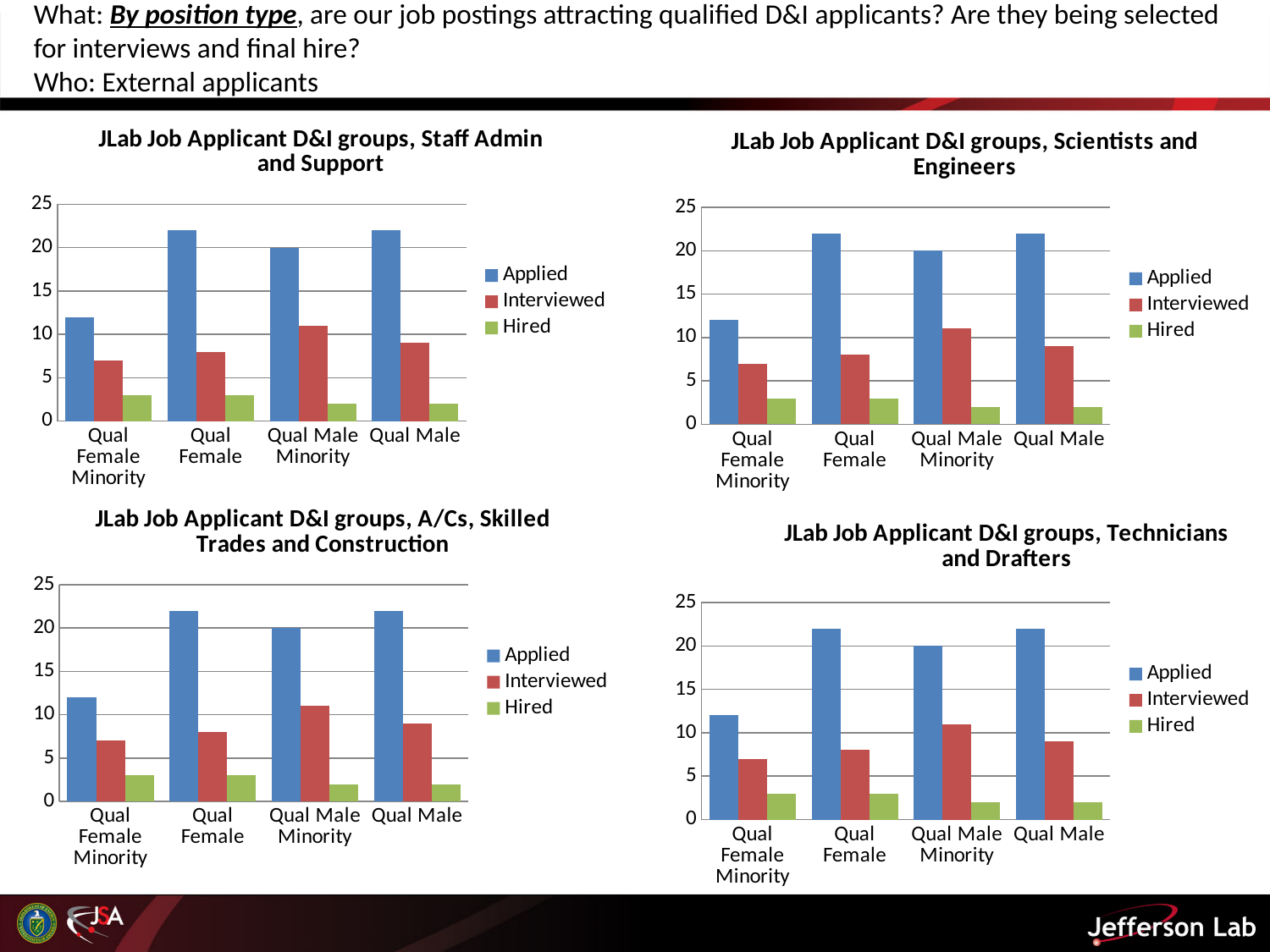
In the 'JLab Job Applicant D&I groups, A/Cs, Skilled Trades and Construction' chart, is the Hired value for Qual Male greater or less than 5? less In the 'JLab Job Applicant D&I groups, Technicians and Drafters' chart, how many categories are shown on the x axis? 4 In the 'JLab Job Applicant D&I groups, Scientists and Engineers' chart, is the Applied value for Qual Female Minority greater or less than 10? greater In the 'JLab Job Applicant D&I groups, Staff Admin and Support' chart, which is larger: the Interviewed value for Qual Male Minority or the Interviewed value for Qual Female Minority? Qual Male Minority In the 'JLab Job Applicant D&I groups, Staff Admin and Support' chart, what kind of chart is shown? bar chart In the 'JLab Job Applicant D&I groups, Technicians and Drafters' chart, which series is shown in green in the legend? Hired In the 'JLab Job Applicant D&I groups, Scientists and Engineers' chart, how many series does the legend list? 3 In the 'JLab Job Applicant D&I groups, Scientists and Engineers' chart, which is larger: the Applied value for Qual Female or the Applied value for Qual Female Minority? Qual Female In the 'JLab Job Applicant D&I groups, A/Cs, Skilled Trades and Construction' chart, is the Interviewed value for Qual Male Minority greater or less than 10? greater In the 'JLab Job Applicant D&I groups, A/Cs, Skilled Trades and Construction' chart, which category has the lowest Applied value? Qual Female Minority In the 'JLab Job Applicant D&I groups, Staff Admin and Support' chart, which category has the highest Interviewed value? Qual Male Minority